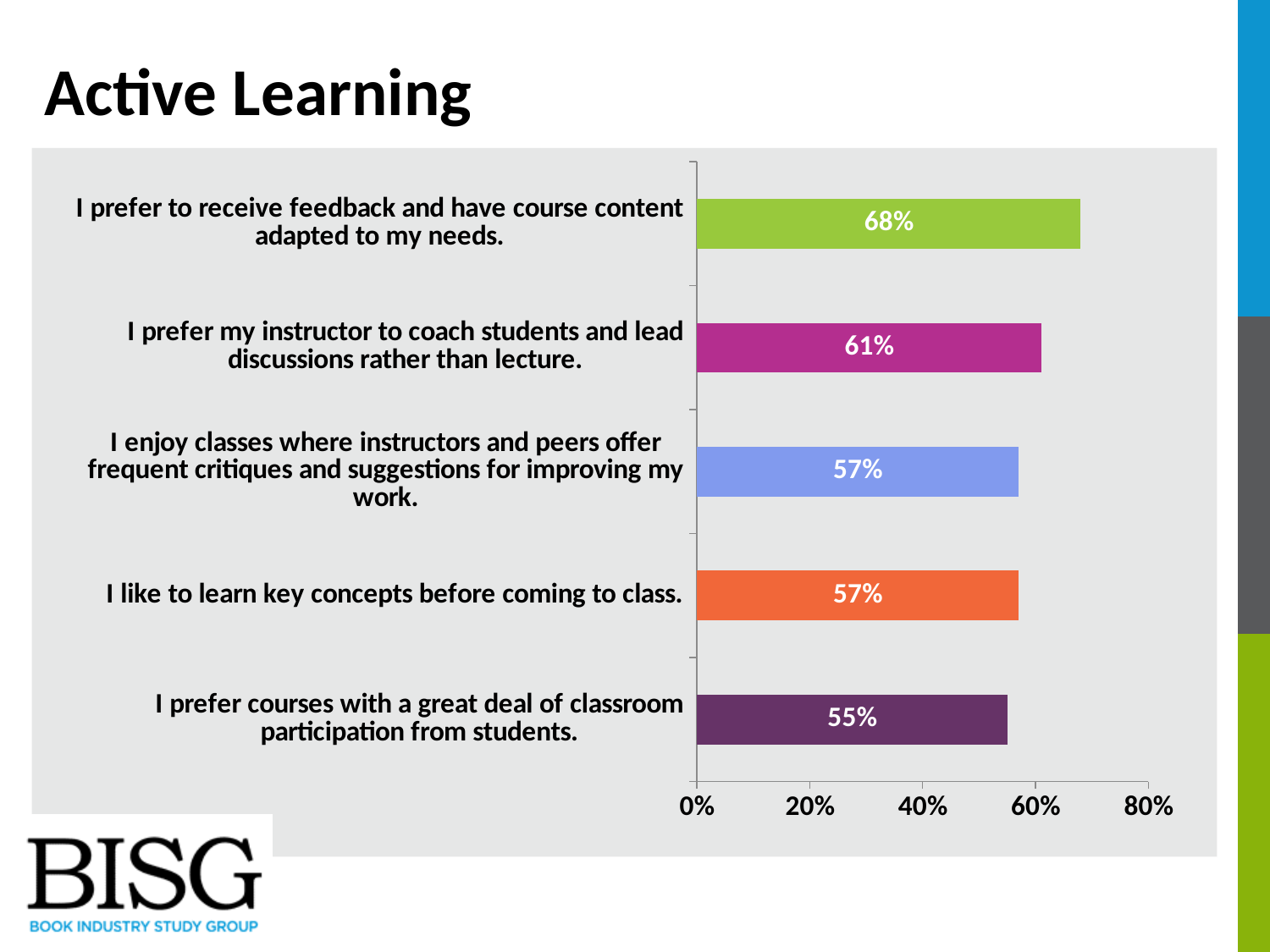
What is the difference between the highest value (68%) and the lowest value (55%)? 13% Which statement has the highest percentage? I prefer to receive feedback and have course content adapted to my needs. What is the difference between the values for "I prefer my instructor to coach students and lead discussions rather than lecture." and "I like to learn key concepts before coming to class."? 4% What percentage of respondents said they prefer to receive feedback and have course content adapted to their needs? 68% How many statements (bars) are shown in the chart? 5 What is the value for "I like to learn key concepts before coming to class."? 57% What type of chart is shown on the slide? Bar chart What is the value for "I prefer courses with a great deal of classroom participation from students."? 55% Which statement has the lowest percentage? I prefer courses with a great deal of classroom participation from students. Which is larger: the value for "I prefer my instructor to coach students and lead discussions rather than lecture." or the value for "I prefer courses with a great deal of classroom participation from students."? I prefer my instructor to coach students and lead discussions rather than lecture. What is the value for "I prefer my instructor to coach students and lead discussions rather than lecture."? 61% What is the title of the slide containing the chart? Active Learning